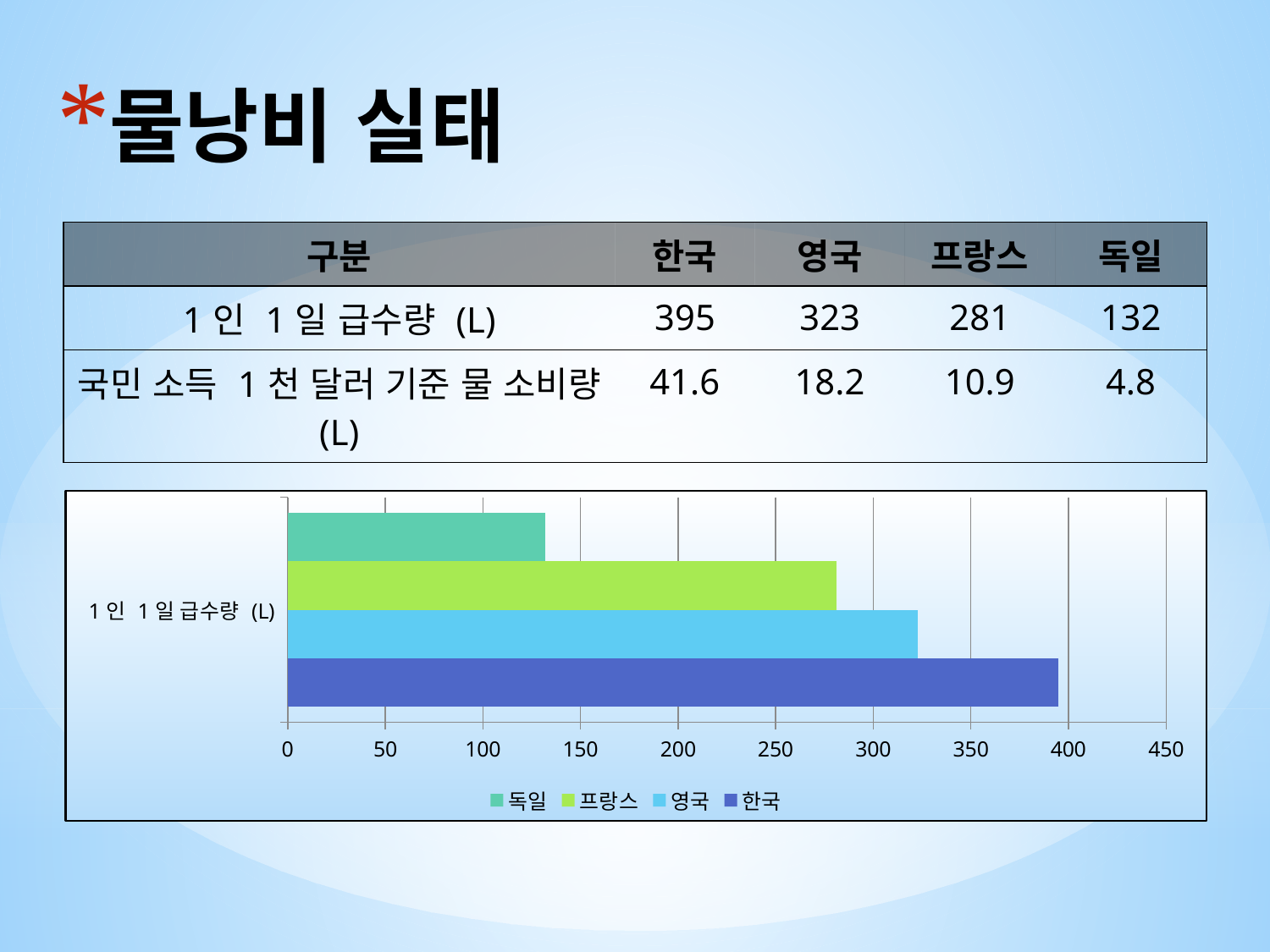
In the chart, is the bar for 영국 longer or shorter than the bar for 프랑스? longer What category label appears on the vertical axis of the chart? 1 인 1 일 급수량 (L) Is the value for 영국 in the chart greater or less than 300? greater What is the value of 1 인 1 일 급수량 (L) for 한국, as printed in the table? 395 What kind of chart is shown on the slide? bar chart Which series has the longest bar in the chart? 한국 Is the value for 프랑스 in the chart greater or less than 250? greater Is the value for 독일 in the chart greater or less than 150? less How many series does the chart's legend list? 4 What is the difference between the 1 인 1 일 급수량 (L) values for 한국 and 독일 printed in the table? 263 Which series has the shortest bar in the chart? 독일